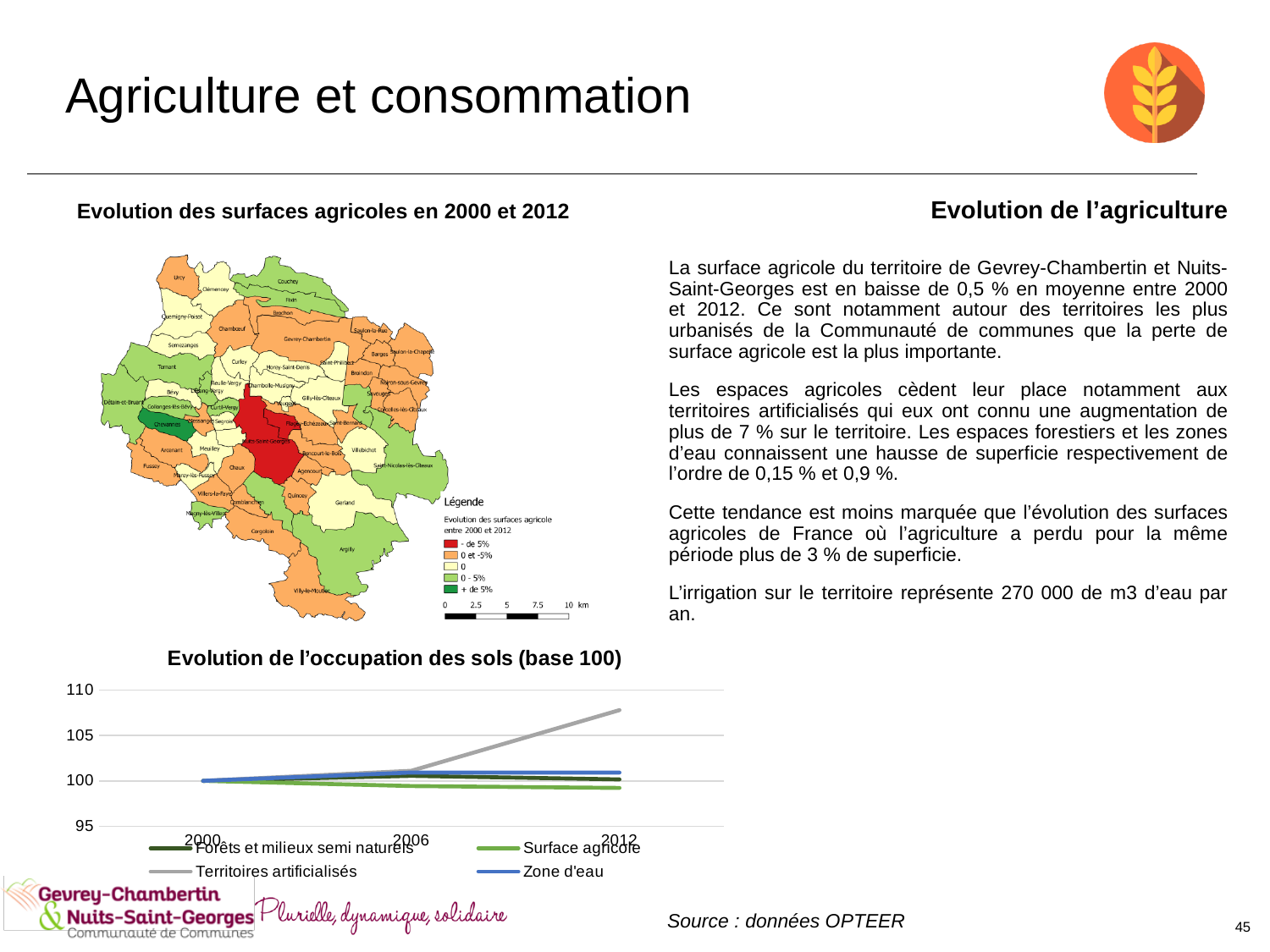
In the 'Evolution de l'occupation des sols (base 100)' chart, which series has the highest value in 2012? Territoires artificialisés In the 'Evolution de l'occupation des sols (base 100)' chart, which series has the lowest value in 2012? Surface agricole What kind of chart is 'Evolution de l'occupation des sols (base 100)'? line chart In the 'Evolution de l'occupation des sols (base 100)' chart, what is the value of all series in 2000? 100 In the 'Evolution de l'occupation des sols (base 100)' chart, is the value for Territoires artificialisés in 2012 greater or less than 105? greater How many series does the legend of the 'Evolution de l'occupation des sols (base 100)' chart list? 4 In the 'Evolution de l'occupation des sols (base 100)' chart, does the value for Territoires artificialisés rise or fall between 2000 and 2012? rise How many years are shown on the x axis of the 'Evolution de l'occupation des sols (base 100)' chart? 3 In the 'Evolution de l'occupation des sols (base 100)' chart, does the value for Surface agricole rise or fall between 2000 and 2012? fall In the 'Evolution de l'occupation des sols (base 100)' chart, is the value for Surface agricole in 2012 greater or less than 100? less In the 'Evolution de l'occupation des sols (base 100)' chart, which is larger in 2012: Territoires artificialisés or Zone d'eau? Territoires artificialisés What is the title of the line chart at the bottom of the slide? Evolution de l'occupation des sols (base 100)